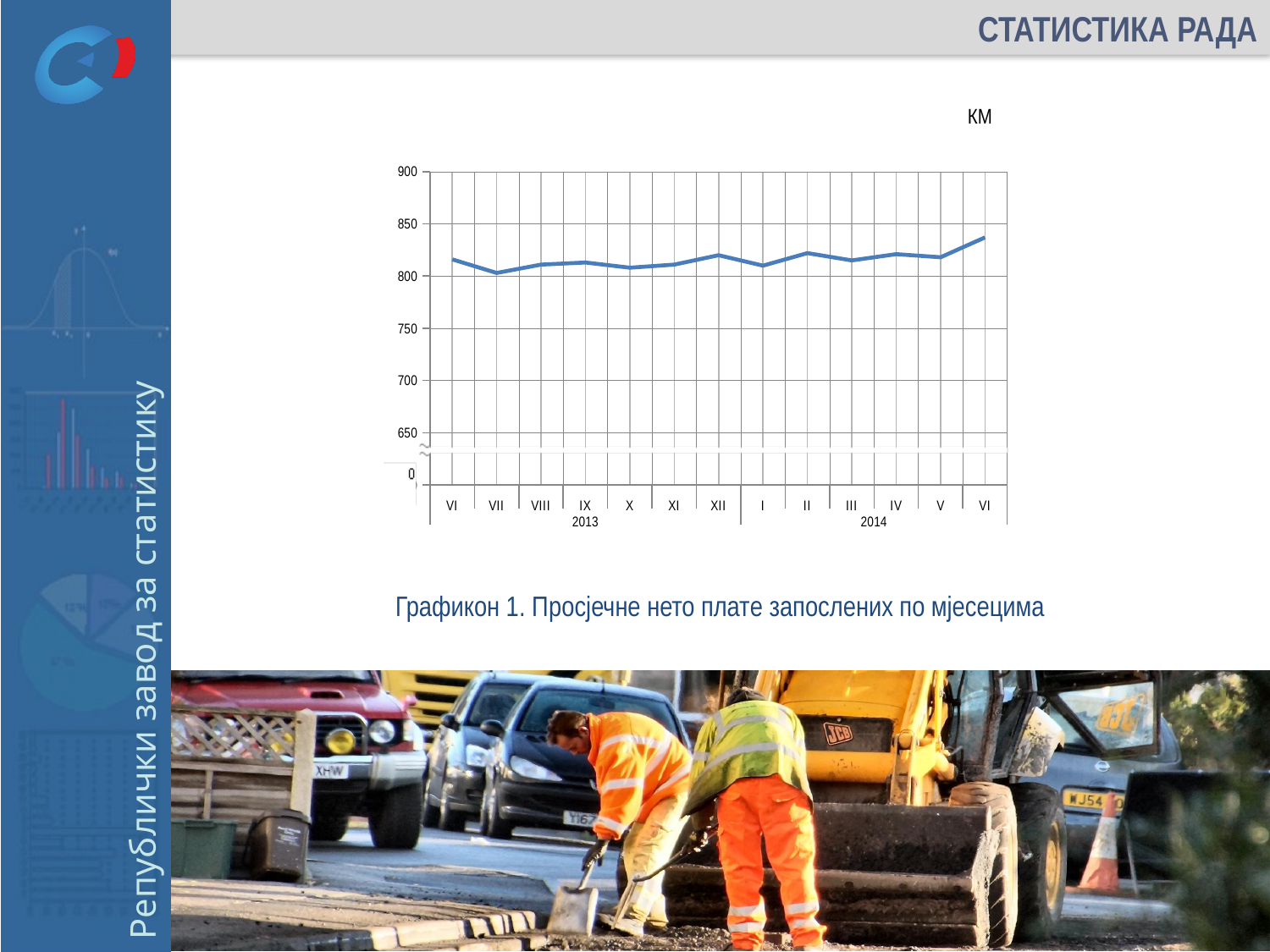
What unit is indicated above the chart? KM What kind of chart is shown on the slide? line chart Does the value rise or fall from VI 2013 to VII 2013? fall How many monthly data points are plotted on the chart? 13 Does the value rise or fall from V 2014 to VI 2014? rise Which month has the highest value on the chart? VI 2014 Is the value for XII 2013 greater or less than 800? greater Which month has the lowest value on the chart? VII 2013 Is the value for VI 2014 greater or less than 850? less What is the title of the chart on the slide? Графикон 1. Просјечне нето плате запослених по мјесецима Is the value for II 2014 greater or less than 750? greater Which is larger, the value for VI 2014 or the value for VII 2013? VI 2014